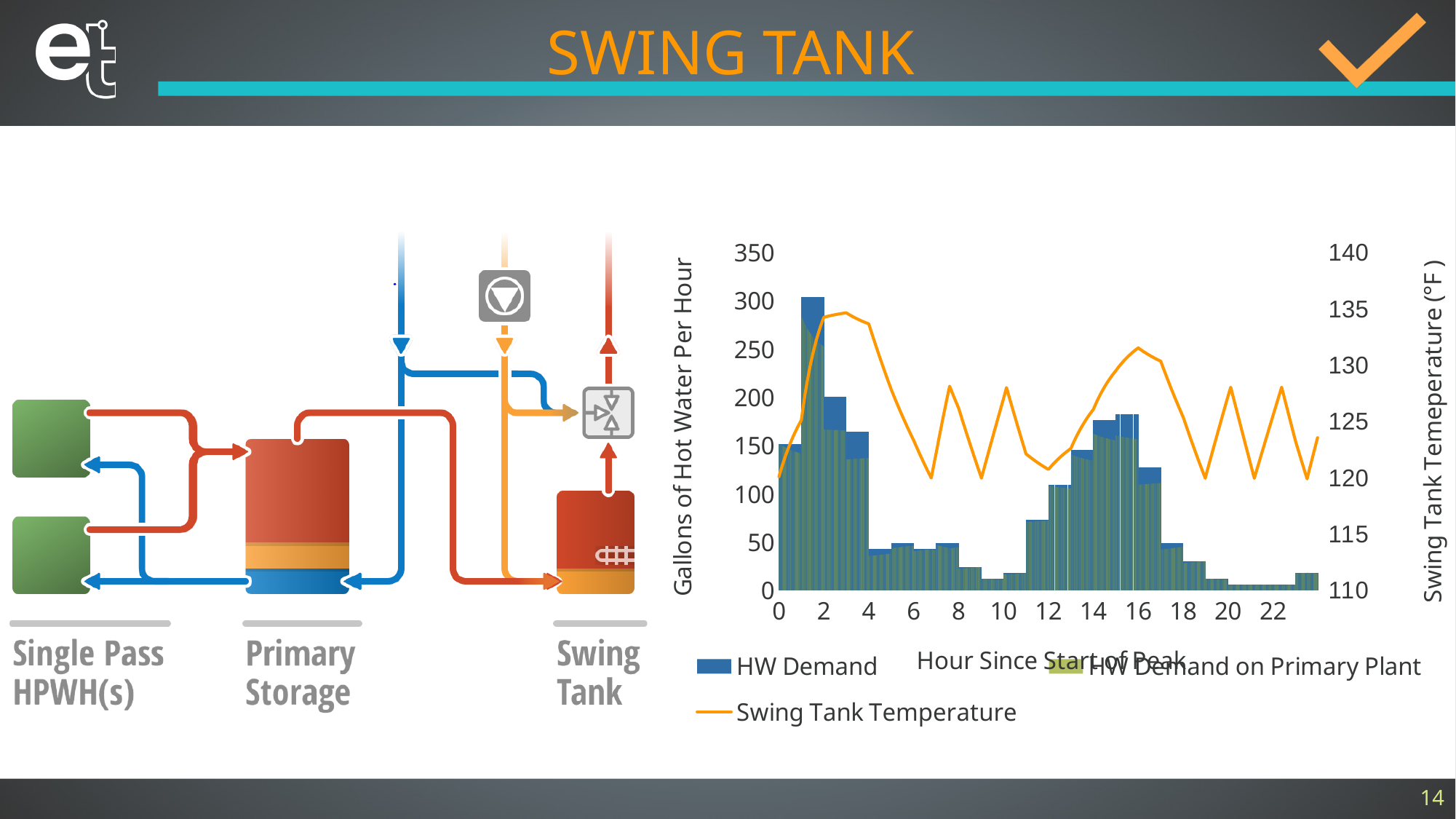
Which is larger, the HW Demand at hour 1 or the HW Demand at hour 15? Hour 1 What is the title of the left vertical axis of the chart? Gallons of Hot Water Per Hour Is the Swing Tank Temperature at hour 3 greater or less than 130? greater What is the title of the horizontal axis of the chart? Hour Since Start of Peak Is the HW Demand value at hour 1 greater or less than 250? greater What is the highest tick value shown on the left vertical axis? 350 Is the Swing Tank Temperature at hour 0 greater or less than 125? less How many series does the chart's legend list? 3 At which hour is the HW Demand bar highest? 1 What kind of chart is shown on the slide? A combined bar and line chart Between hour 1 and hour 10, does HW Demand rise or fall? fall